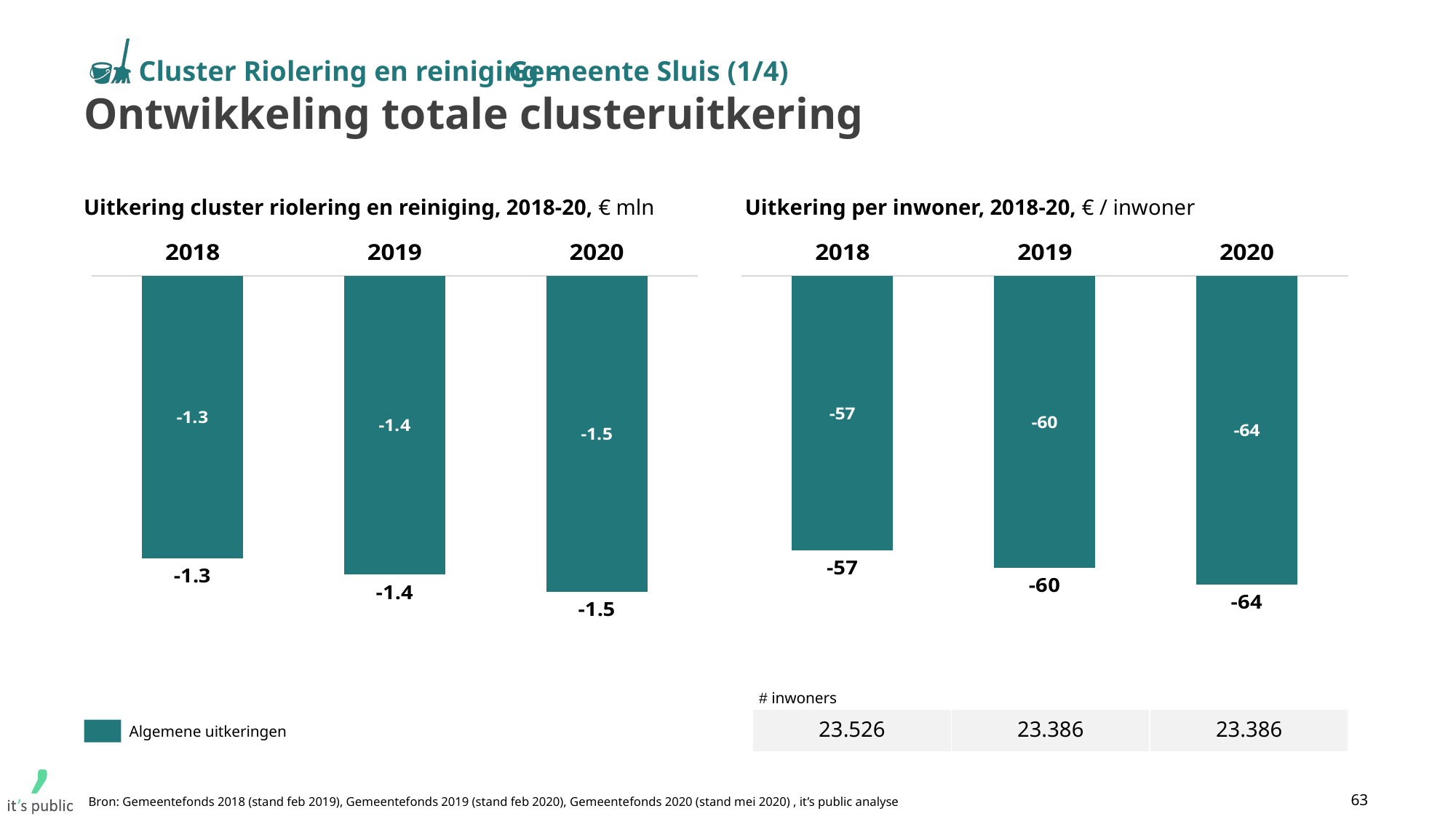
In the chart 'Uitkering per inwoner, 2018-20', is the bar for 2018 or the bar for 2019 longer? 2019 In the chart 'Uitkering cluster riolering en reiniging, 2018-20', what is the value for 2020? -1.5 In the chart 'Uitkering per inwoner, 2018-20', what is the value for 2019? -60 In the chart 'Uitkering cluster riolering en reiniging, 2018-20', which year has the highest (least negative) value? 2018 In the chart 'Uitkering cluster riolering en reiniging, 2018-20', what is the difference between the 2019 value and the 2020 value? 0.1 In the chart 'Uitkering per inwoner, 2018-20', what is the value for 2020? -64 In the chart 'Uitkering per inwoner, 2018-20', what is the difference between the 2018 value and the 2020 value? 7 How many years are shown in the chart 'Uitkering cluster riolering en reiniging, 2018-20'? 3 In the chart 'Uitkering cluster riolering en reiniging, 2018-20', what is the value for 2018? -1.3 What is the legend entry shown below the left chart? Algemene uitkeringen In the chart 'Uitkering per inwoner, 2018-20', which year has the lowest (most negative) value? 2020 What kind of chart is 'Uitkering per inwoner, 2018-20'? Bar chart